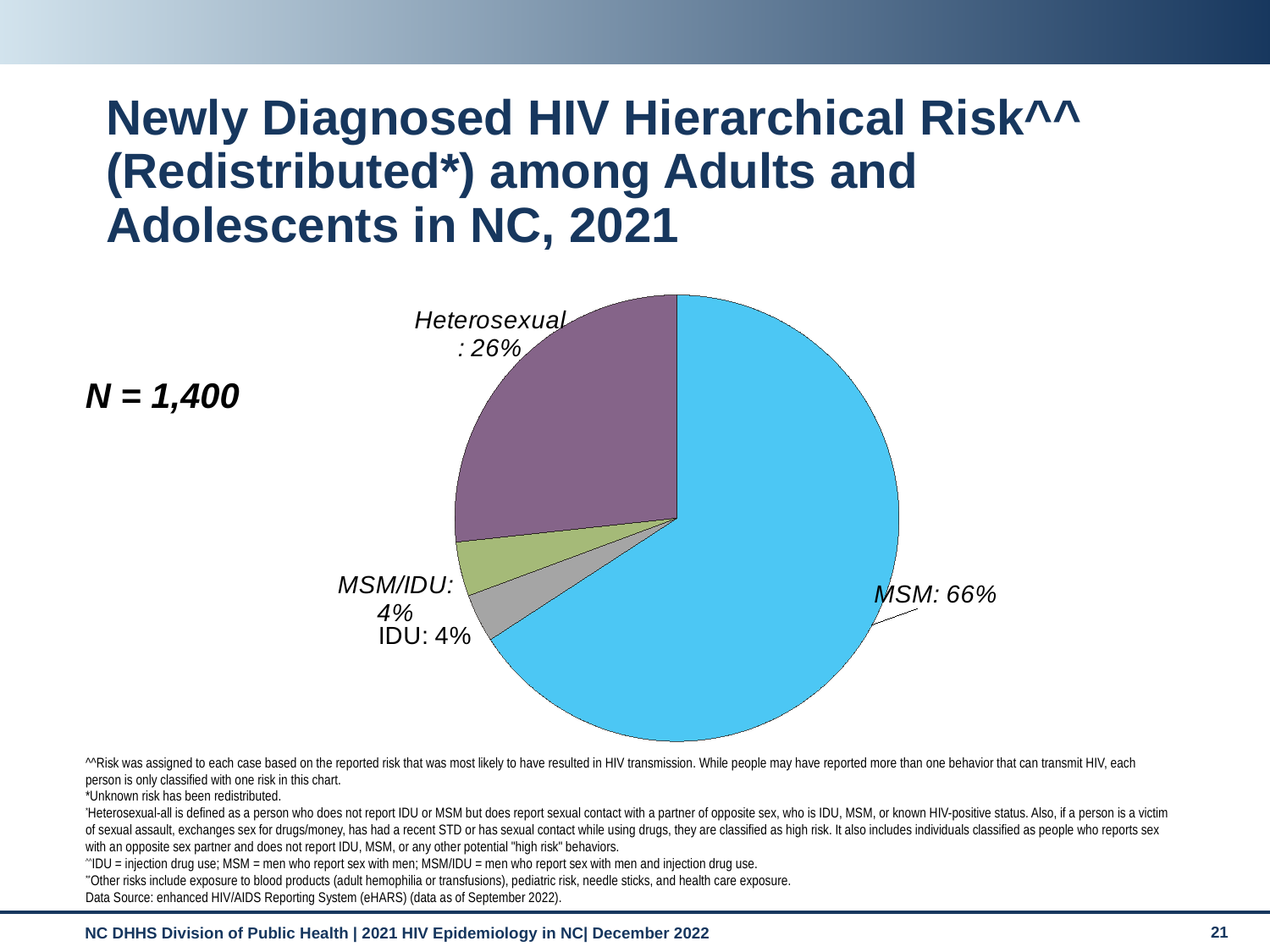
What share of newly diagnosed HIV cases is attributed to MSM? 66% What colour is the MSM slice of the pie? blue What share of newly diagnosed HIV cases is attributed to Heterosexual risk? 26% How many risk categories are labelled on the pie chart? 4 What kind of chart is shown on the slide? pie chart What is the difference in percentage points between the MSM and Heterosexual slices? 40 Which slice is larger, Heterosexual or IDU? Heterosexual What share of newly diagnosed HIV cases is attributed to MSM/IDU? 4% Which risk category has the largest slice of the pie? MSM What is the total number of cases (N) shown on the slide? 1,400 What is the combined share of the IDU and MSM/IDU slices? 8%